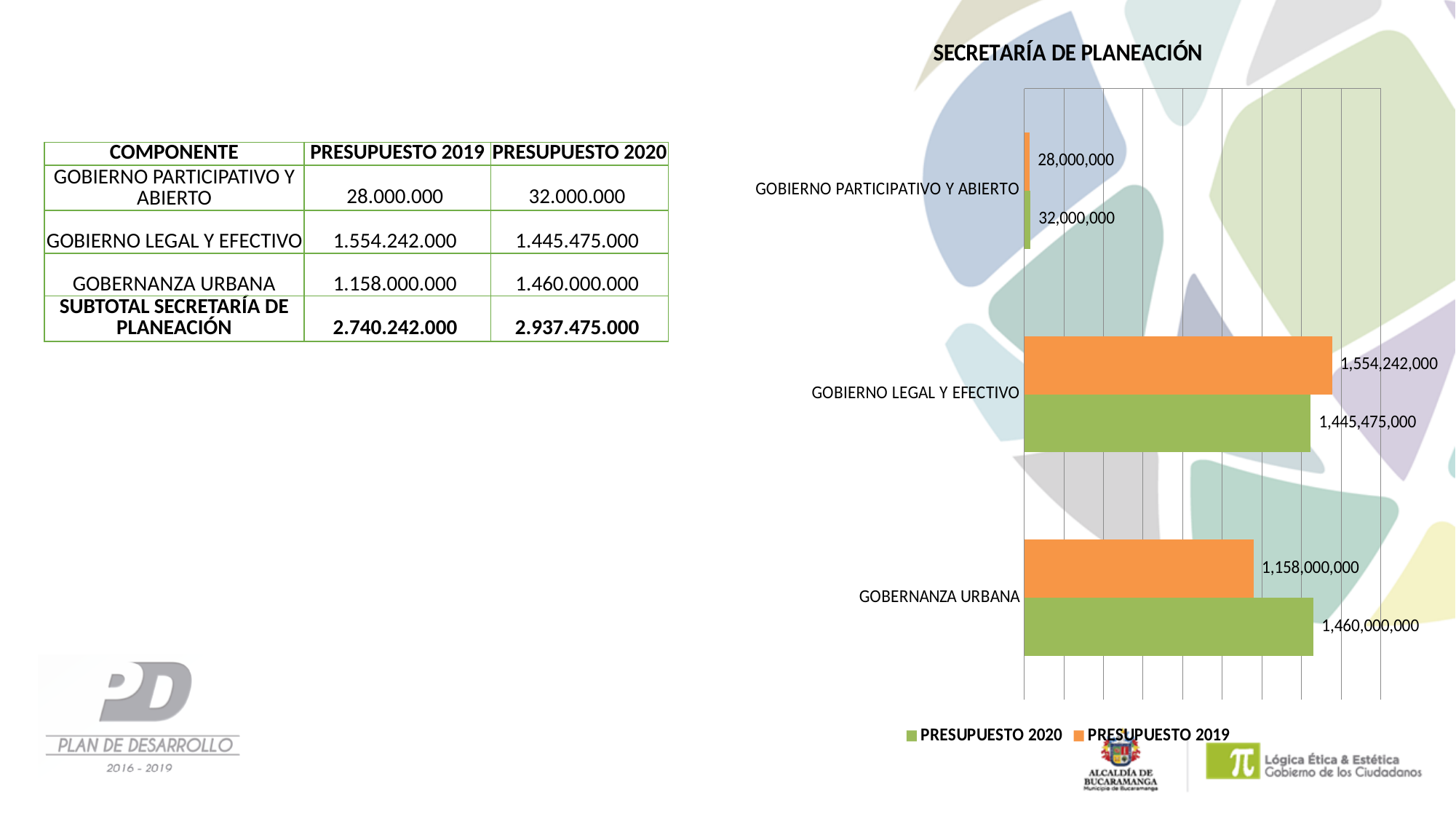
What is the PRESUPUESTO 2019 value for GOBIERNO PARTICIPATIVO Y ABIERTO in the chart? 28,000,000 What is the PRESUPUESTO 2020 value for GOBIERNO LEGAL Y EFECTIVO in the chart? 1,445,475,000 What is the difference between the PRESUPUESTO 2019 and PRESUPUESTO 2020 values for GOBIERNO LEGAL Y EFECTIVO? 108,767,000 For GOBIERNO PARTICIPATIVO Y ABIERTO, which is larger: PRESUPUESTO 2019 or PRESUPUESTO 2020? PRESUPUESTO 2020 What is the PRESUPUESTO 2019 value for GOBIERNO LEGAL Y EFECTIVO in the chart? 1,554,242,000 What is the PRESUPUESTO 2020 value for GOBERNANZA URBANA in the chart? 1,460,000,000 What is the difference between the PRESUPUESTO 2020 and PRESUPUESTO 2019 values for GOBERNANZA URBANA? 302,000,000 How many categories are shown in the chart? 3 What type of chart is shown on the slide? Bar chart Which category has the highest PRESUPUESTO 2019 value in the chart? GOBIERNO LEGAL Y EFECTIVO How many series does the chart legend list? 2 Which category has the lowest PRESUPUESTO 2020 value in the chart? GOBIERNO PARTICIPATIVO Y ABIERTO